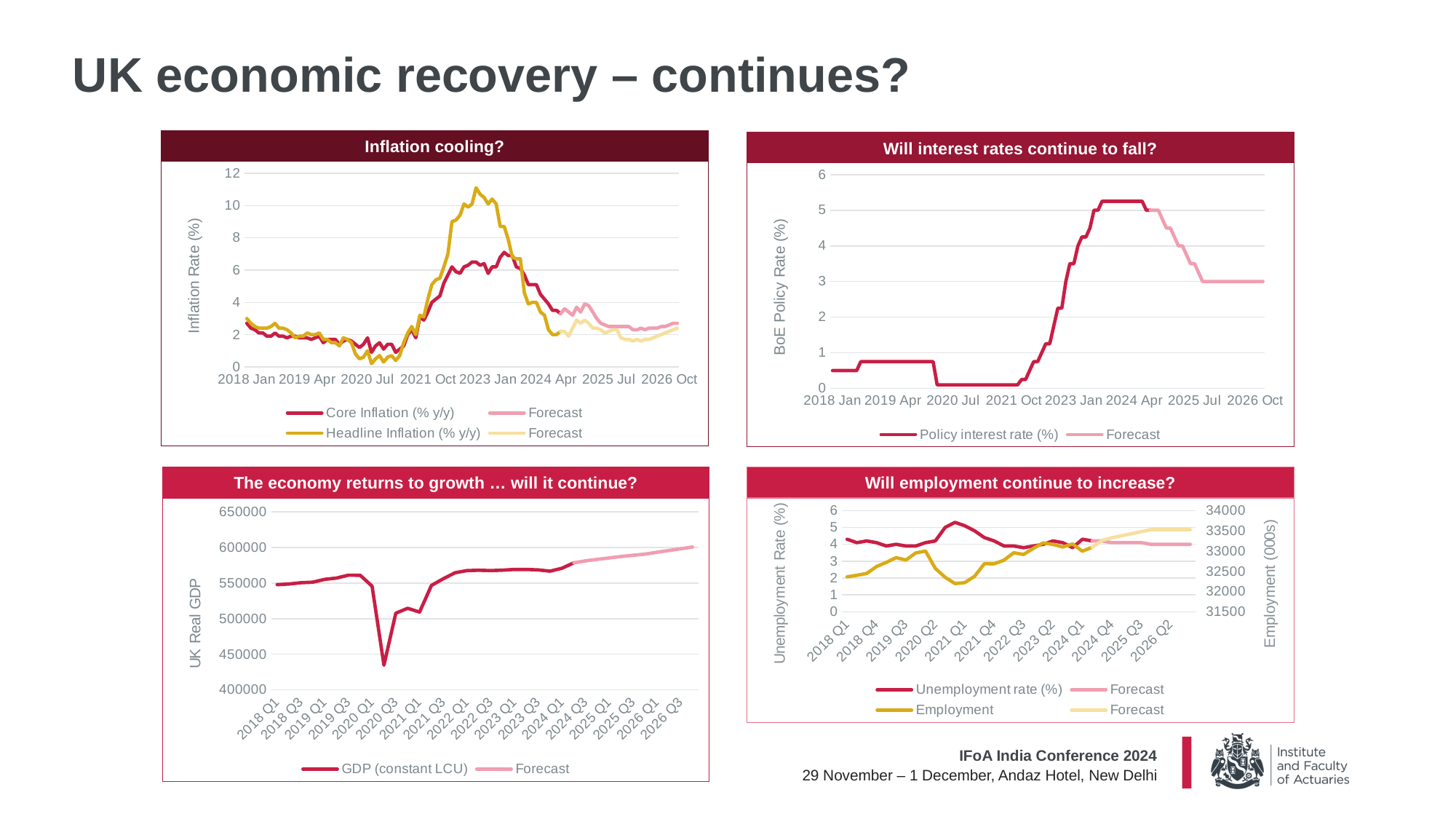
How many series does the legend of the "Will employment continue to increase?" chart list? 4 How many series does the legend of the "Will interest rates continue to fall?" chart list? 2 What is the y-axis label of the bottom-left chart? UK Real GDP In the "Will interest rates continue to fall?" chart, does the Forecast series rise or fall from 2024 to 2026? fall In the "The economy returns to growth … will it continue?" chart, is the lowest GDP value (around 2020 Q2) greater or less than 450000? less How many series does the legend of the "Inflation cooling?" chart list? 4 What kind of chart is the "Inflation cooling?" chart? line chart What is the title of the bottom-right chart? Will employment continue to increase? In the "Will interest rates continue to fall?" chart, is the policy interest rate around 2020 Jul greater or less than 1? less In the "Inflation cooling?" chart, is the peak value of Headline Inflation greater or less than 10? greater In the "The economy returns to growth … will it continue?" chart, does the Forecast series rise or fall from 2024 Q3 to 2026 Q3? rise In the "Inflation cooling?" chart, at the 2023 peak, which series is higher: Core Inflation or Headline Inflation? Headline Inflation